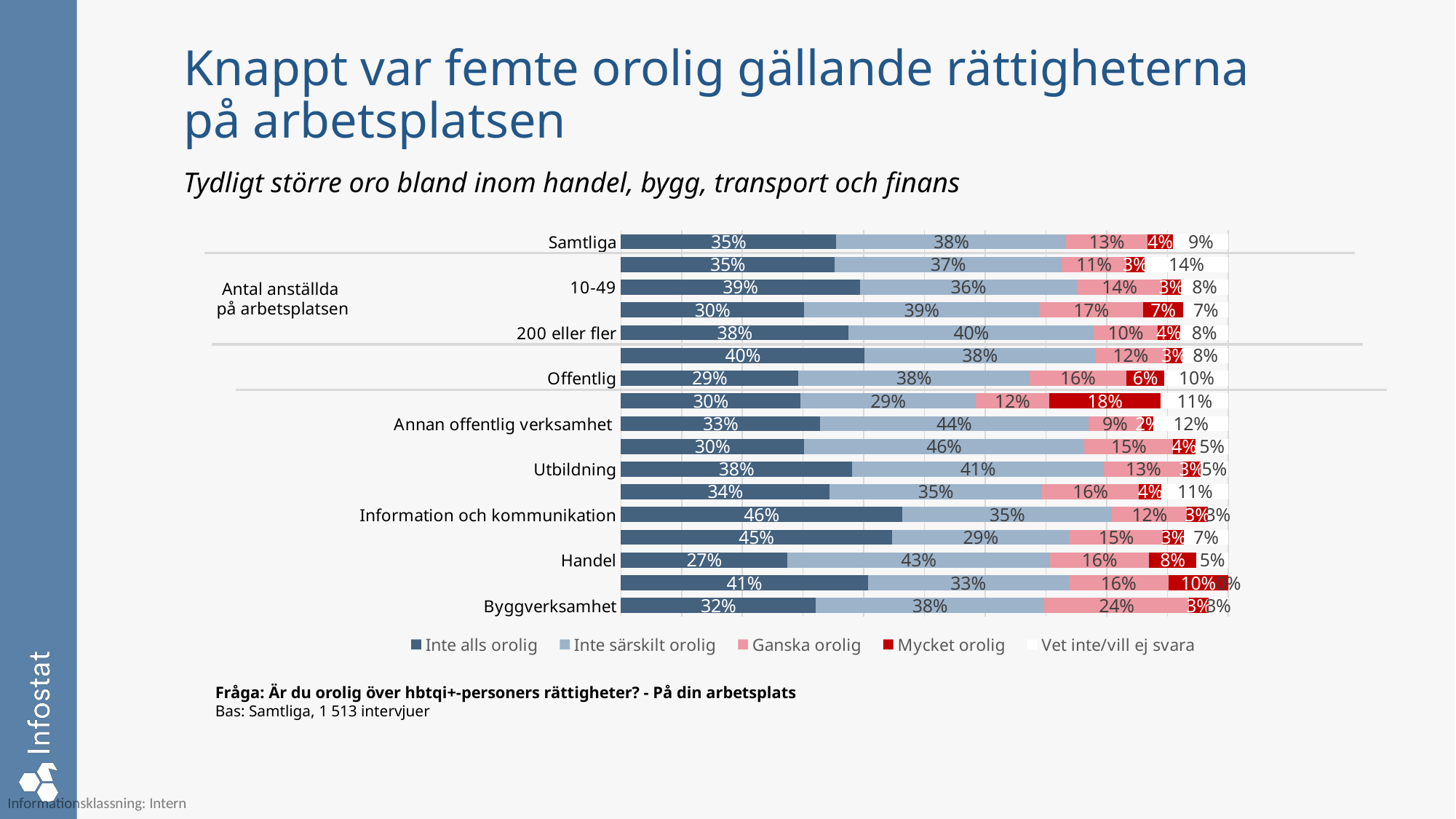
What is the 'Ganska orolig' value for Byggverksamhet? 24% How many series does the legend list? 5 Which category has the lowest 'Inte alls orolig' value? Handel Which is larger, the 'Inte alls orolig' value for Utbildning or for Offentlig? Utbildning What is the 'Mycket orolig' value for Handel? 8% What is the 'Inte särskilt orolig' value for 200 eller fler? 40% Which category has the highest 'Inte alls orolig' value? Information och kommunikation What is the difference between the 'Ganska orolig' values for Byggverksamhet and Samtliga? 11 percentage points What is the 'Vet inte/vill ej svara' value for Annan offentlig verksamhet? 12% What is the 'Inte alls orolig' value for Samtliga? 35% What kind of chart is shown on the slide? Stacked bar chart What is the total of the stacked bar for Utbildning? 100%